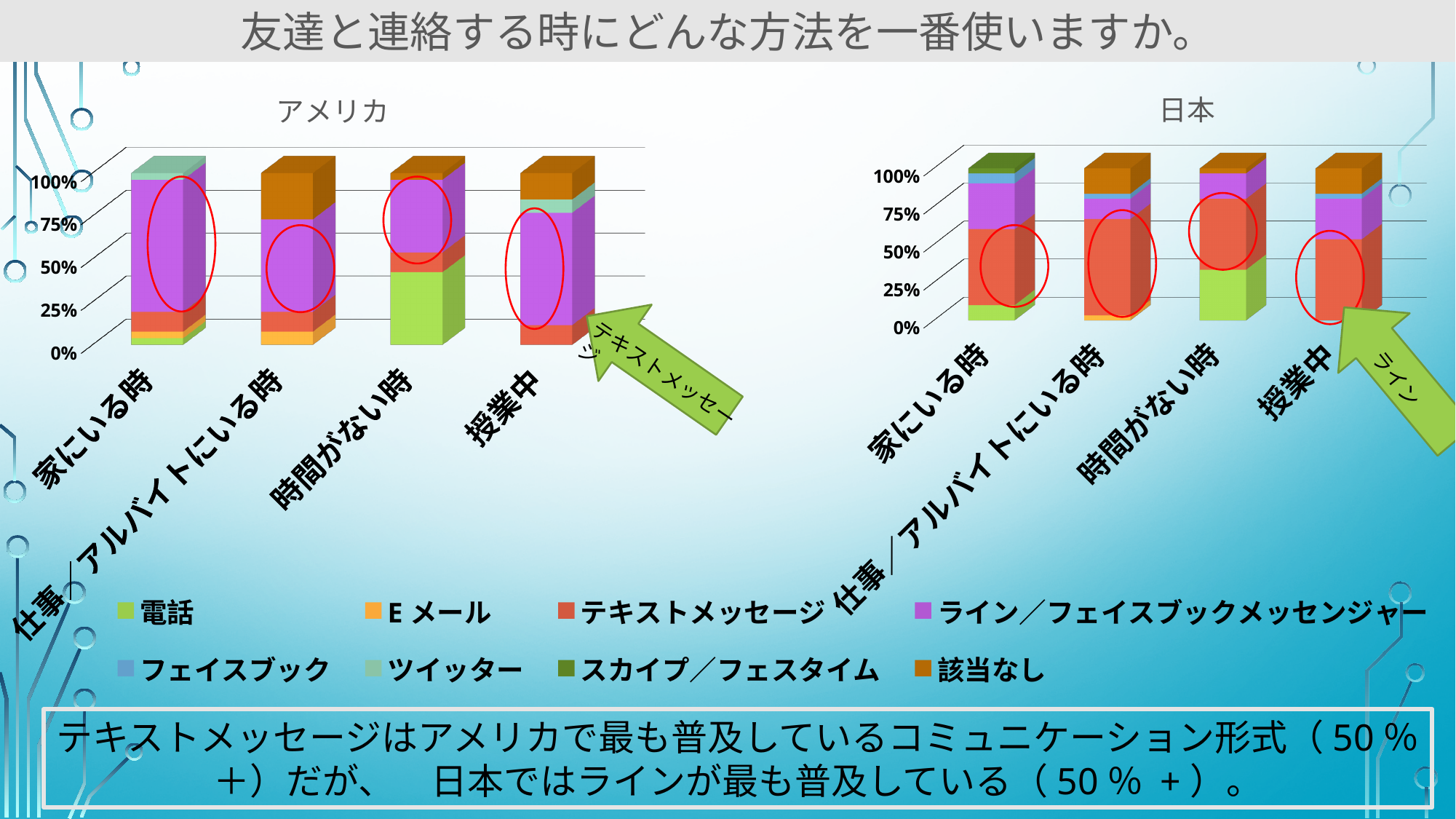
In the 日本 chart, is the 電話 segment for 家にいる時 greater or less than 25%? less What is the title of the chart on the left? アメリカ In the 日本 chart, is the 電話 segment for 時間がない時 greater or less than 25%? greater How many categories are shown on the x axis of the 日本 chart? 4 What is the highest value labelled on the vertical axis of the 日本 chart? 100% In the アメリカ chart, which category has the largest 電話 segment? 時間がない時 What is the title of the chart on the right? 日本 In the アメリカ chart, is the 電話 segment for 時間がない時 greater or less than 25%? greater How many series does the shared legend list? 8 What kind of chart is the アメリカ chart? stacked bar chart In the 日本 chart, which category has the largest 電話 segment? 時間がない時 In the アメリカ chart, is the 電話 segment larger for 時間がない時 or for 家にいる時? 時間がない時